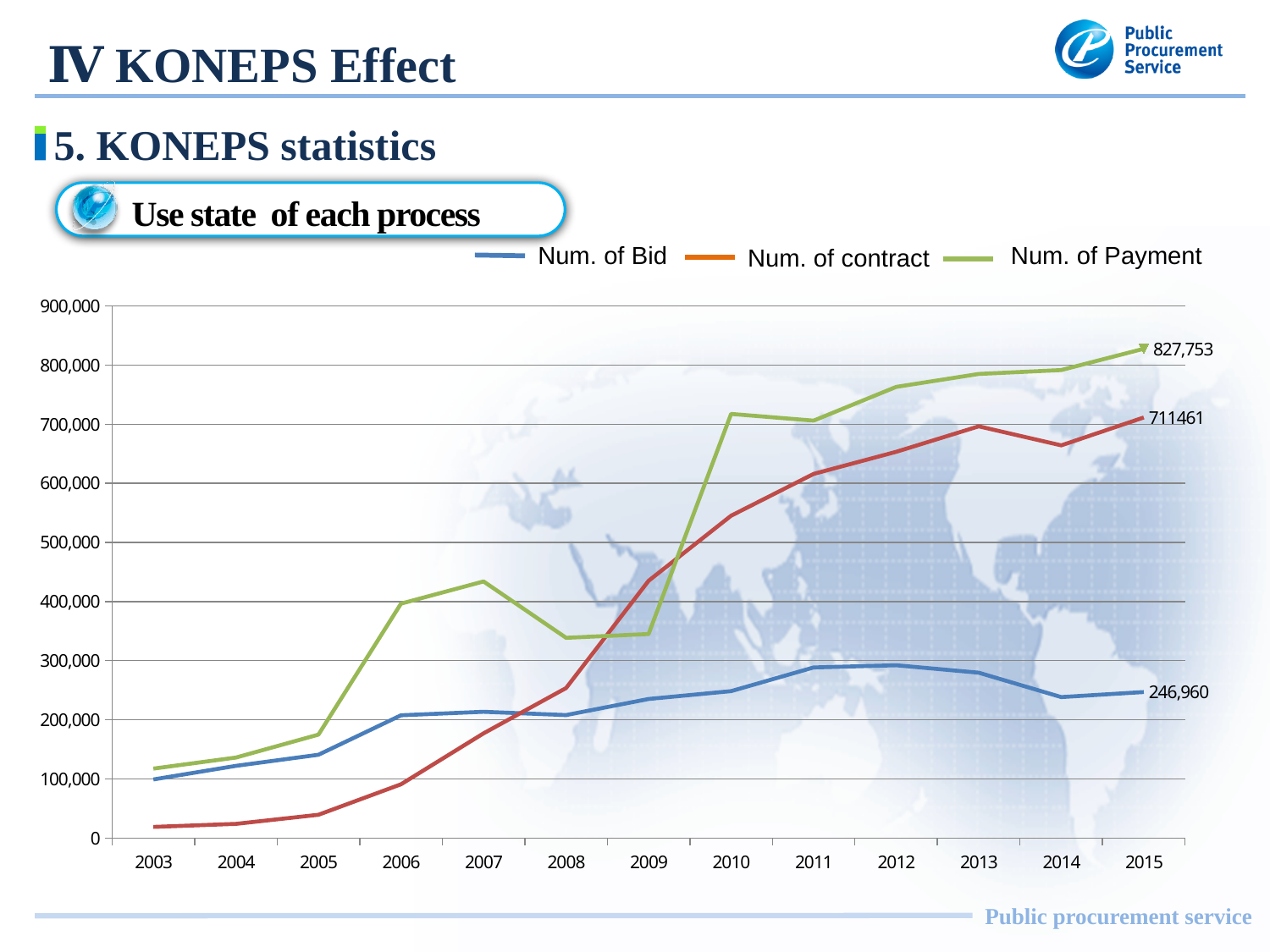
What is the value of Num. of contract in 2015? 711461 How many years are shown on the x axis? 13 What is the difference between Num. of Payment and Num. of Bid in 2015? 580,793 What kind of chart is shown on the slide? Line chart Which series has the lowest value in 2003? Num. of contract How many series does the legend list? 3 Is the value for Num. of Payment in 2010 greater or less than 600,000? greater Is the value for Num. of contract in 2003 greater or less than 100,000? less What is the value of Num. of Payment in 2015? 827,753 Which series has the highest value in 2015? Num. of Payment Does Num. of contract rise or fall from 2003 to 2015 overall? Rise What is the value of Num. of Bid in 2015? 246,960